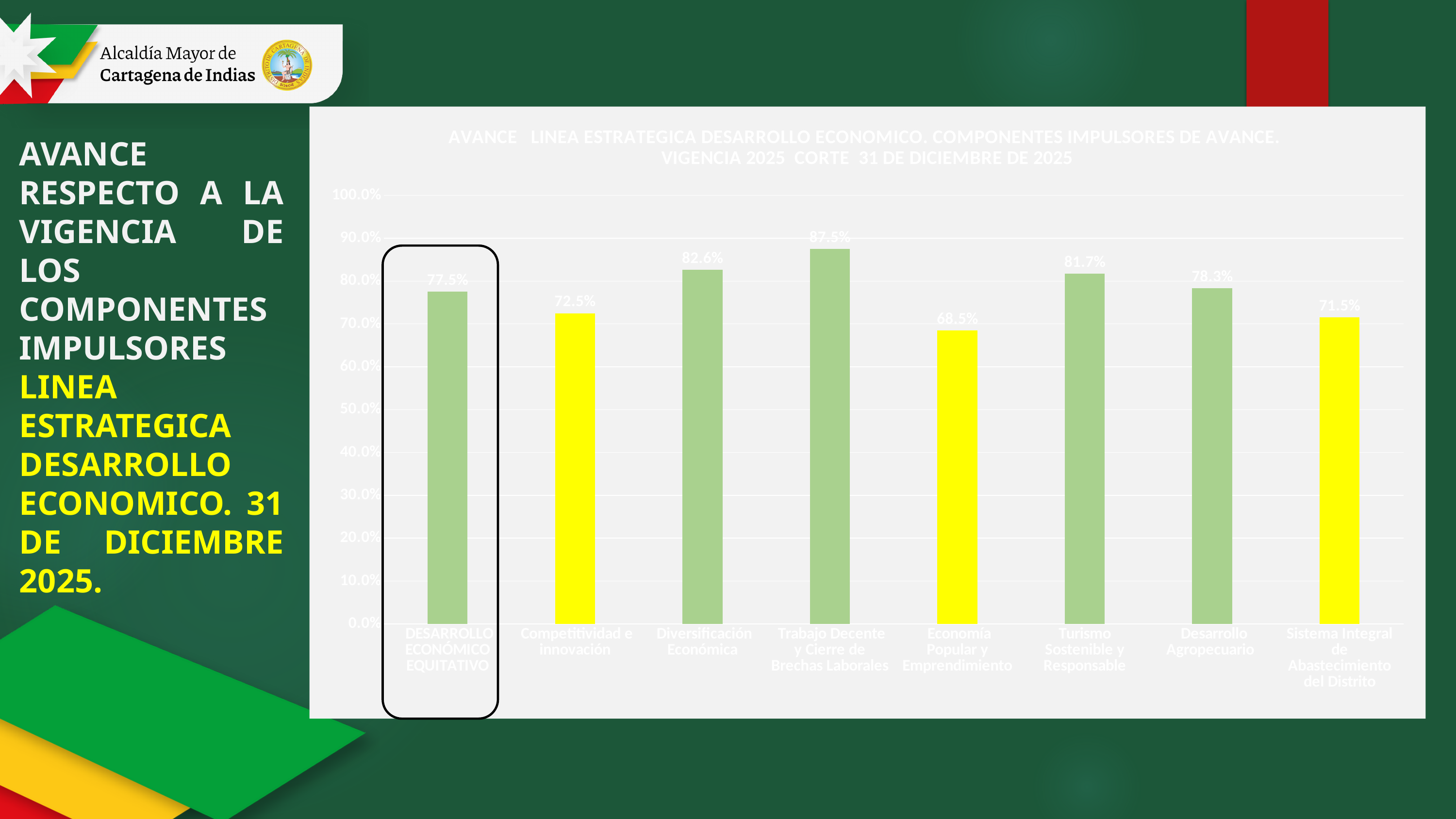
What is the difference between the values for Diversificación Económica and Competitividad e innovación? 10.1% What is the value for DESARROLLO ECONÓMICO EQUITATIVO? 77.5% What kind of chart is shown on the slide? Bar chart Which is larger, the value for Turismo Sostenible y Responsable or the value for Desarrollo Agropecuario? Turismo Sostenible y Responsable What is the value for Trabajo Decente y Cierre de Brechas Laborales? 87.5% How many categories (bars) does the chart show? 8 Which bar on the chart is outlined with a black rounded rectangle? DESARROLLO ECONÓMICO EQUITATIVO What is the value for Economía Popular y Emprendimiento? 68.5% Which category has the highest value? Trabajo Decente y Cierre de Brechas Laborales Which category has the lowest value? Economía Popular y Emprendimiento Is the value for Desarrollo Agropecuario greater or less than 70.0%? greater What is the value for Sistema Integral de Abastecimiento del Distrito? 71.5%